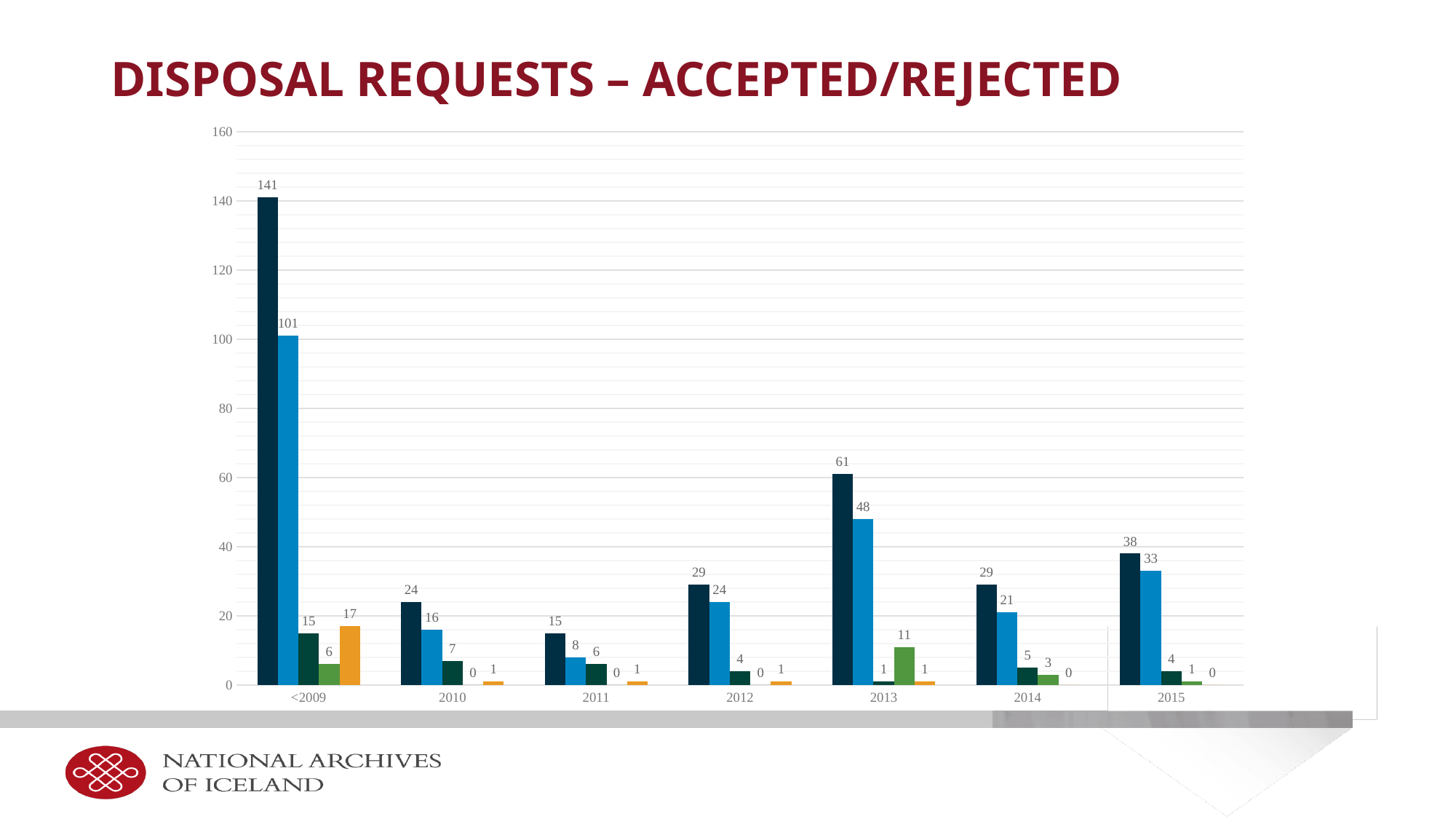
What is the difference between the dark navy bar for 2013 and the dark navy bar for 2015? 23 How many year categories are shown on the x axis? 7 What is the value of the orange (fifth) bar for <2009? 17 What is the title of the slide containing the chart? DISPOSAL REQUESTS – ACCEPTED/REJECTED Which is larger: the light blue bar for 2014 or the light blue bar for 2015? 2015 What is the value of the light blue (second) bar for 2013? 48 What kind of chart is shown on the slide? Bar chart Which year category has the highest dark navy (first) bar? <2009 What is the difference between the dark navy bar and the light blue bar for <2009? 40 Which year category has the lowest dark navy (first) bar? 2011 What is the value of the dark navy (first) bar for <2009? 141 What is the value of the light green (fourth) bar for 2013? 11